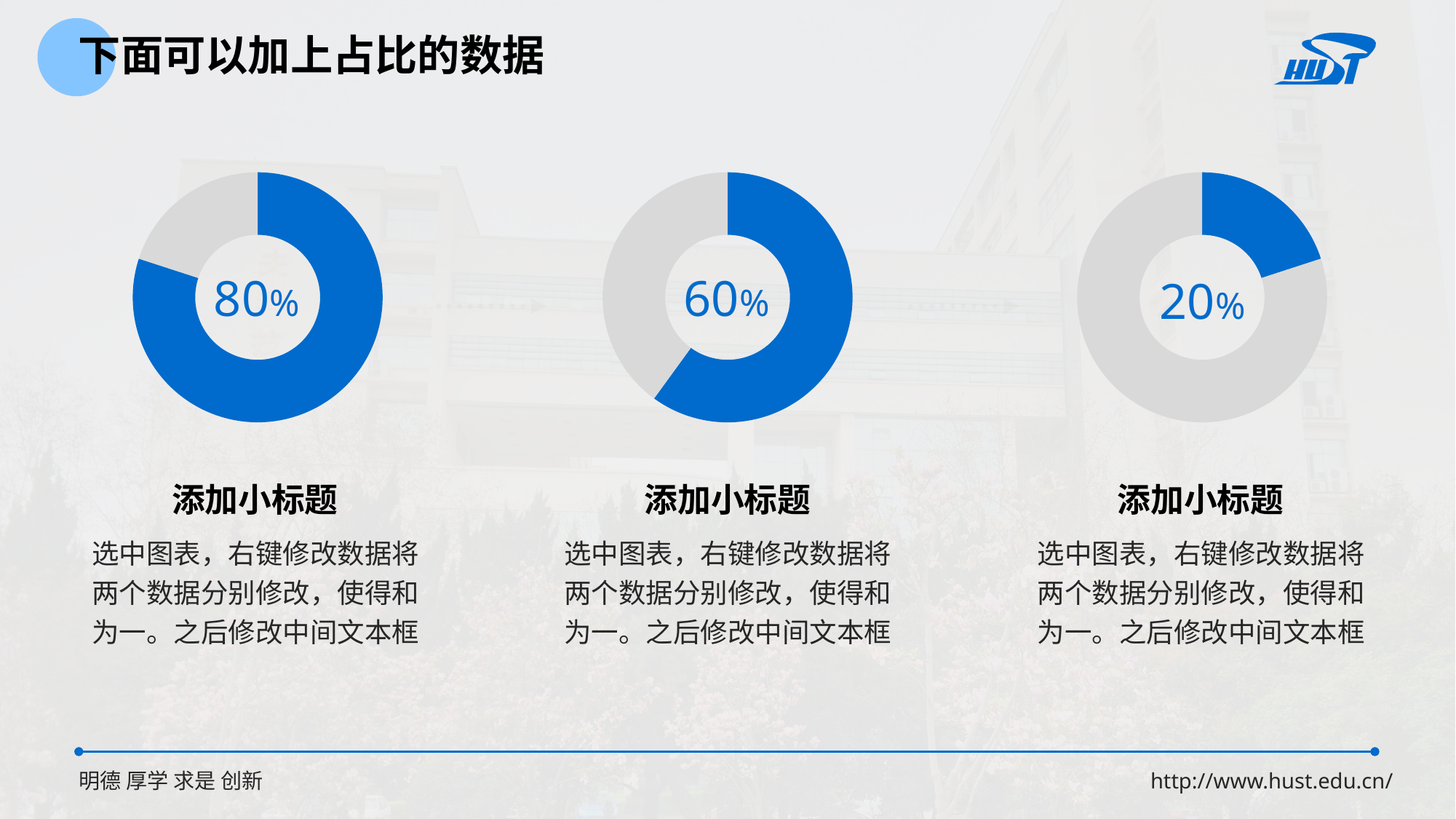
In the right donut chart, what share of the ring is filled in blue? 20% How many donut charts are on the slide? 3 Which of the three donut charts shows the lowest percentage: left, middle or right? right What kind of chart is used on this slide? donut chart What is the difference between the percentage in the left donut chart and the percentage in the middle donut chart? 20% What percentage is shown in the centre of the middle donut chart? 60% Which of the three donut charts shows the highest percentage: left, middle or right? left What is the difference between the percentage in the left donut chart and the percentage in the right donut chart? 60% What percentage is shown in the centre of the right donut chart? 20% What percentage is shown in the centre of the left donut chart? 80% Is the percentage in the middle donut chart larger or smaller than the percentage in the right donut chart? larger What colour is used for the filled portion of each donut chart? blue